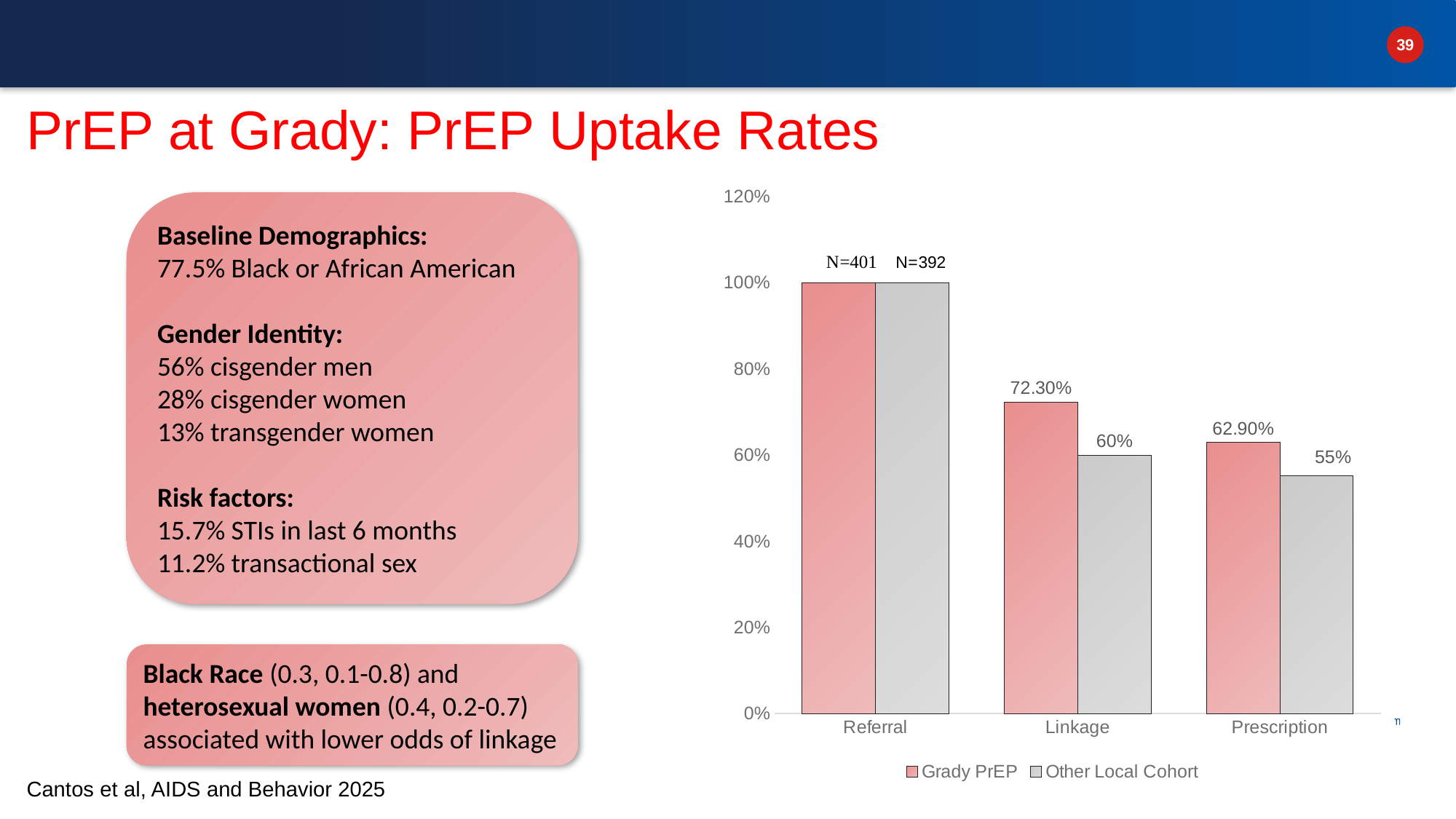
What is the N shown above the Grady PrEP Referral bar? N=401 Which category has the lowest Grady PrEP value? Prescription What is the Grady PrEP value for Prescription? 62.90% What is the Grady PrEP value for Linkage? 72.30% How many series does the legend list? 2 How many categories are shown on the x axis? 3 For Prescription, which series has the larger value, Grady PrEP or Other Local Cohort? Grady PrEP What is the Other Local Cohort value for Prescription? 55% What is the Other Local Cohort value for Linkage? 60% Do the Grady PrEP values rise or fall from Referral to Prescription? fall What is the difference between the Grady PrEP and Other Local Cohort values for Linkage? 12.30% Which category has the highest Other Local Cohort value? Referral